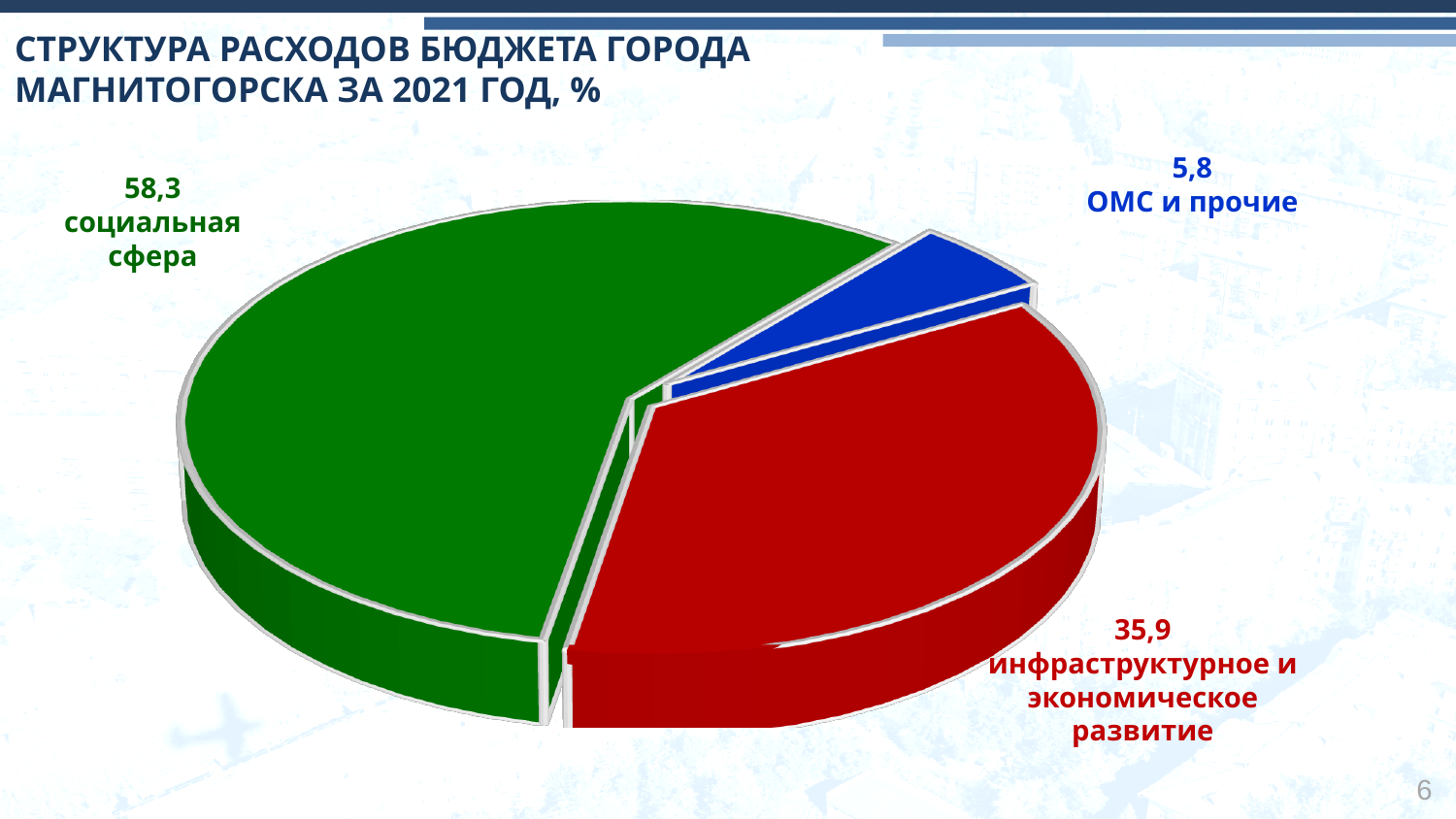
What is the value for ОМС и прочие? 5,8 What is the value for социальная сфера? 58,3 Which is larger: социальная сфера or инфраструктурное и экономическое развитие? социальная сфера Which category has the smallest share of the pie? ОМС и прочие What colour is the slice for ОМС и прочие? blue How many slices does the pie chart have? 3 Which category has the largest share of the pie? социальная сфера What is the title of the chart? СТРУКТУРА РАСХОДОВ БЮДЖЕТА ГОРОДА МАГНИТОГОРСКА ЗА 2021 ГОД, % What is the difference between the values for социальная сфера and инфраструктурное и экономическое развитие? 22,4 What kind of chart is shown on the slide? pie chart What is the value for инфраструктурное и экономическое развитие? 35,9 What is the difference between the values for инфраструктурное и экономическое развитие and ОМС и прочие? 30,1